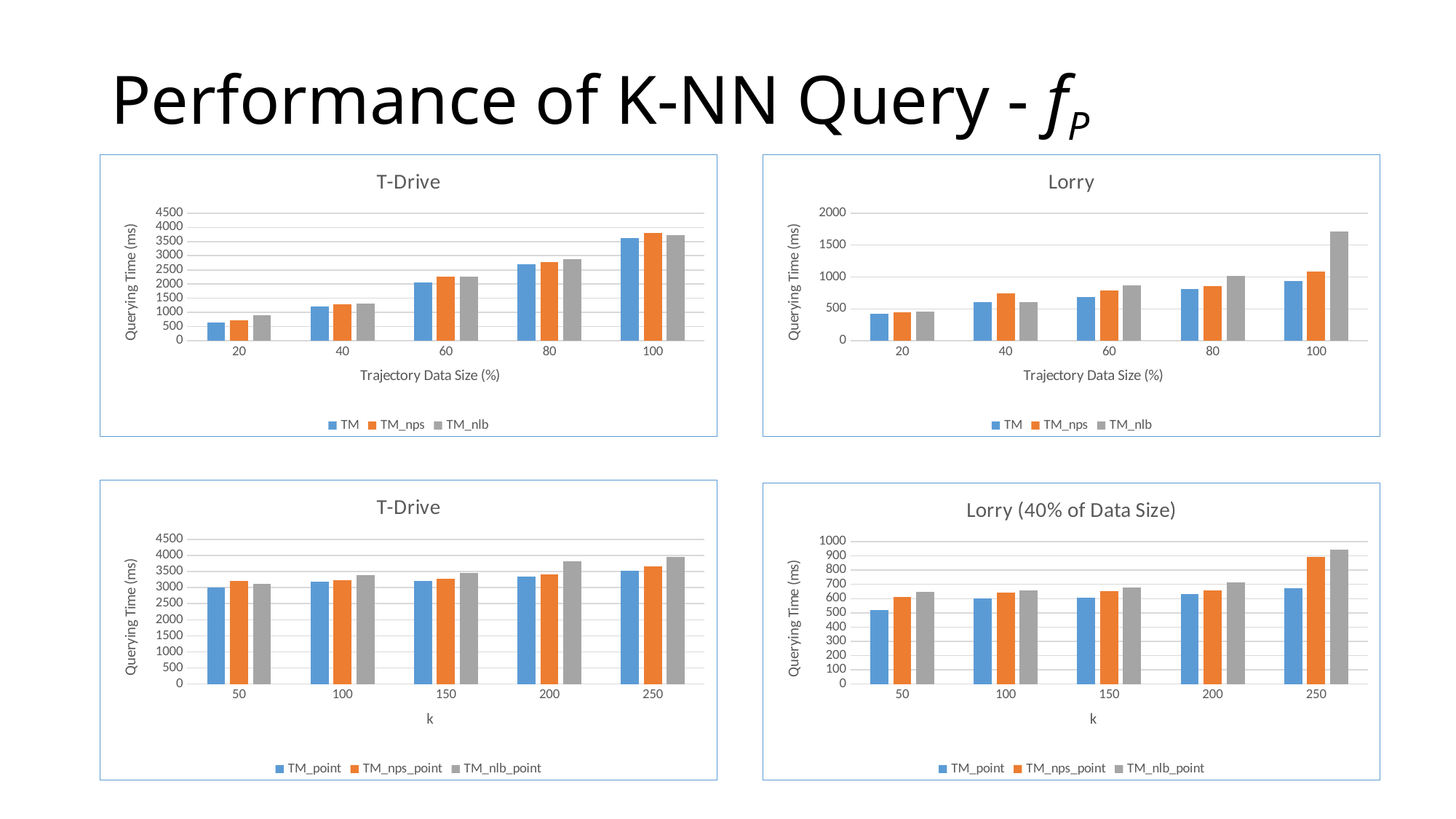
In the top-right Lorry chart, is the value for TM_nlb at data size 100 greater or less than 1500? greater In the top-left T-Drive chart, do the TM values rise or fall as trajectory data size increases? rise In the top-left T-Drive chart, is the value for TM at data size 20 greater or less than 1000? less In the bottom-right Lorry (40% of Data Size) chart, which series has the lowest value at k = 250? TM_point In the bottom-left T-Drive chart, how many k values are shown on the x axis? 5 In the top-right Lorry chart, at data size 40, which is larger: TM or TM_nps? TM_nps In the top-left T-Drive chart, how many series does the legend list? 3 In the top-right Lorry chart, which series has the highest value at trajectory data size 100? TM_nlb What is the x-axis label of the top-right Lorry chart? Trajectory Data Size (%) What kind of chart is the top-right Lorry chart? bar chart In the bottom-left T-Drive chart, is the value for TM_nlb_point at k = 250 greater or less than 3500? greater